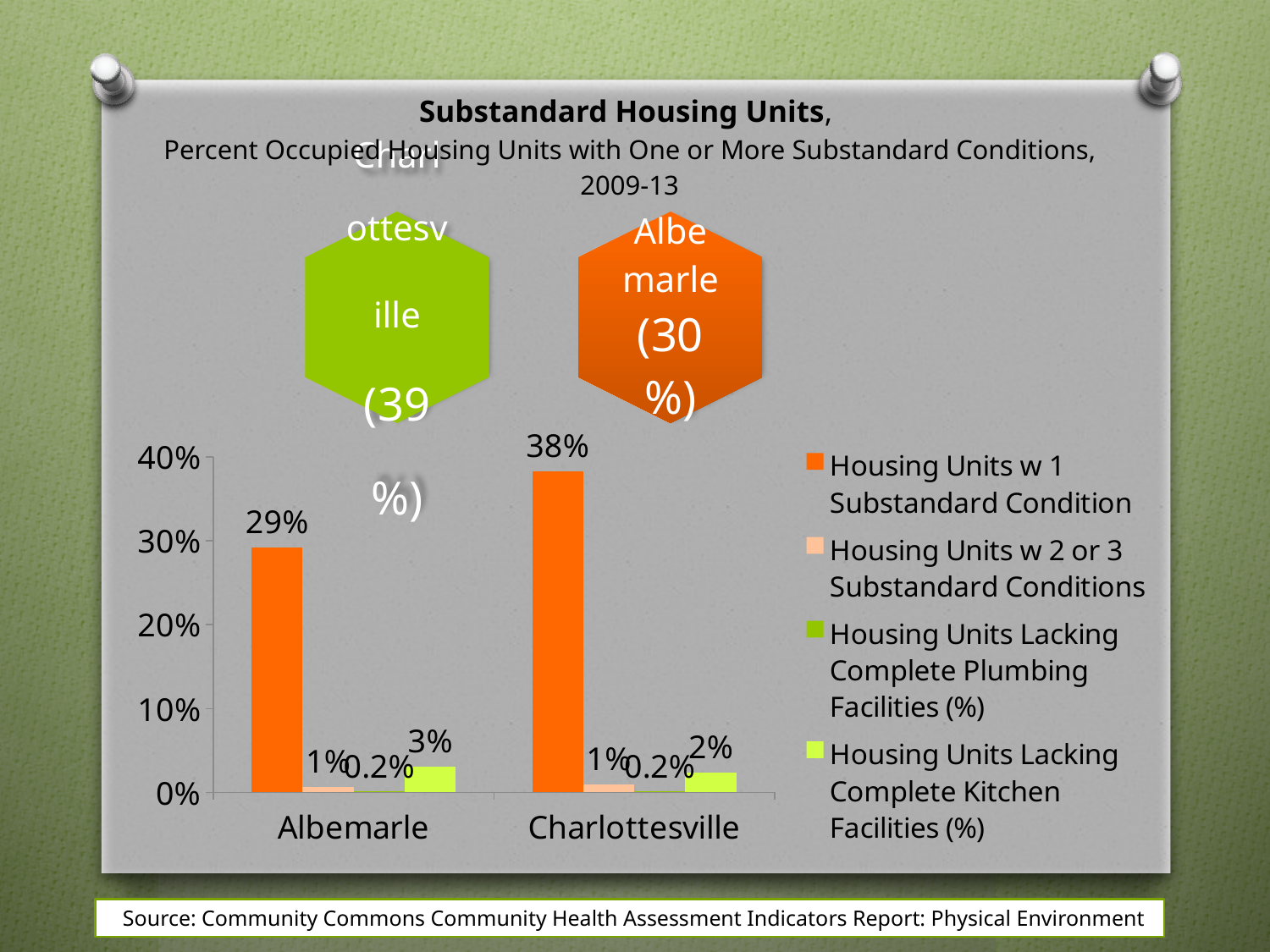
What is the value for Housing Units Lacking Complete Plumbing Facilities (%) in Charlottesville? 0.2% What is the difference between the Housing Units Lacking Complete Kitchen Facilities (%) values for Albemarle and Charlottesville? 1% Which series has the lowest value in Albemarle? Housing Units Lacking Complete Plumbing Facilities (%) How many series does the chart legend list? 4 What is the difference between the Housing Units w 1 Substandard Condition values for Charlottesville and Albemarle? 9% What is the value for Housing Units w 1 Substandard Condition in Charlottesville? 38% Which locality has the higher value for Housing Units w 1 Substandard Condition? Charlottesville Is the value for Housing Units w 1 Substandard Condition in Charlottesville greater or less than 30%? greater What kind of chart is shown on the slide? bar chart What is the value for Housing Units Lacking Complete Kitchen Facilities (%) in Albemarle? 3% What is the value for Housing Units w 1 Substandard Condition in Albemarle? 29% How many localities are shown on the x axis of the chart? 2